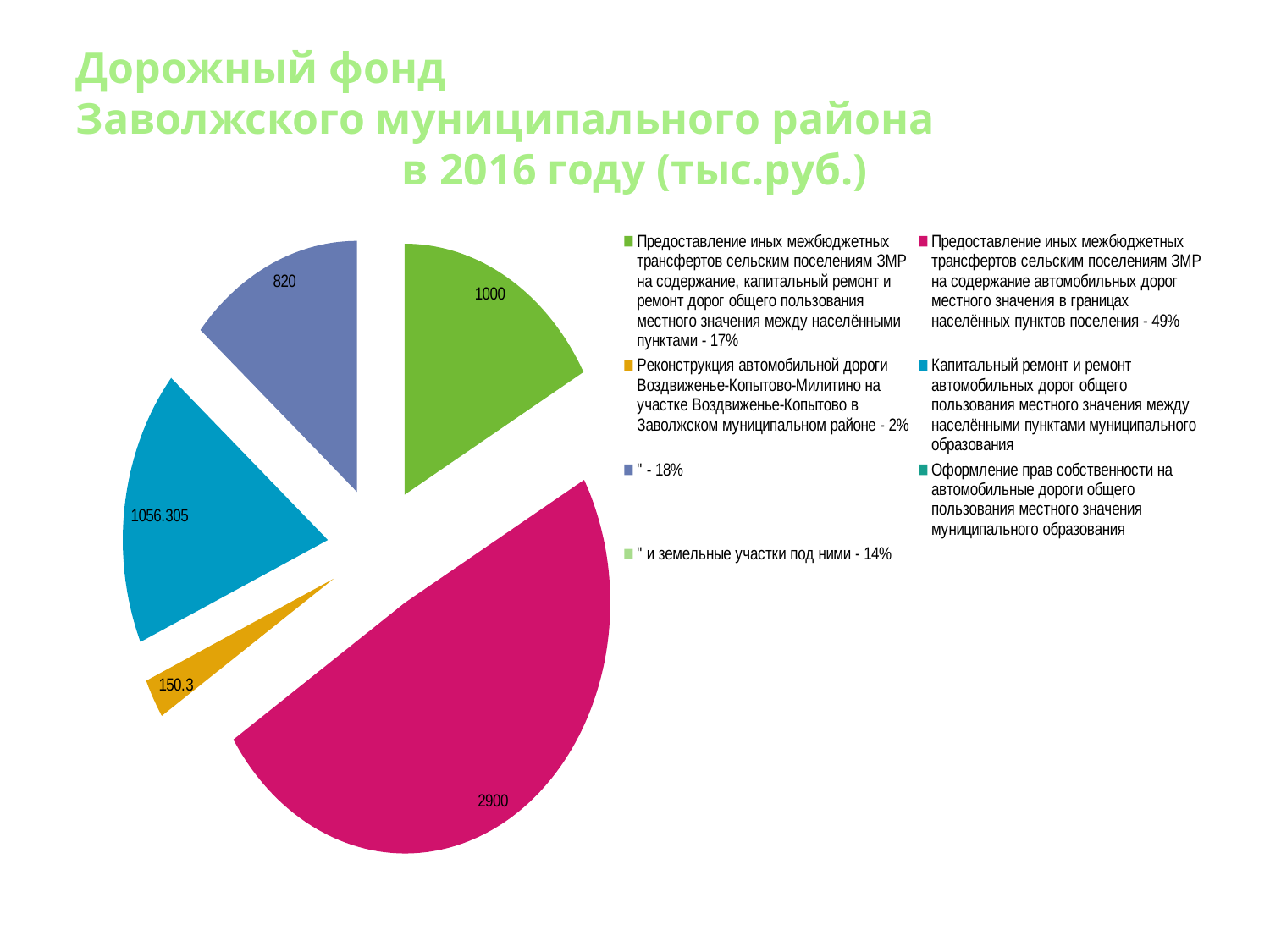
What is the value of the yellow slice of the pie chart? 150.3 What is the value of the cyan (light blue) slice of the pie chart? 1056.305 Which slice of the pie chart has the largest value? the magenta slice (2900) Which is larger: the cyan slice or the green slice? the cyan slice (1056.305) What kind of chart is shown on the slide? pie chart What is the value of the magenta slice of the pie chart? 2900 What is the difference between the magenta slice (2900) and the green slice (1000)? 1900 What is the title of the slide containing the chart? Дорожный фонд Заволжского муниципального района в 2016 году (тыс.руб.) How many slices does the pie chart have? 5 What is the value of the blue-purple slice of the pie chart? 820 What is the value of the green slice of the pie chart? 1000 Which slice of the pie chart has the smallest value? the yellow slice (150.3)